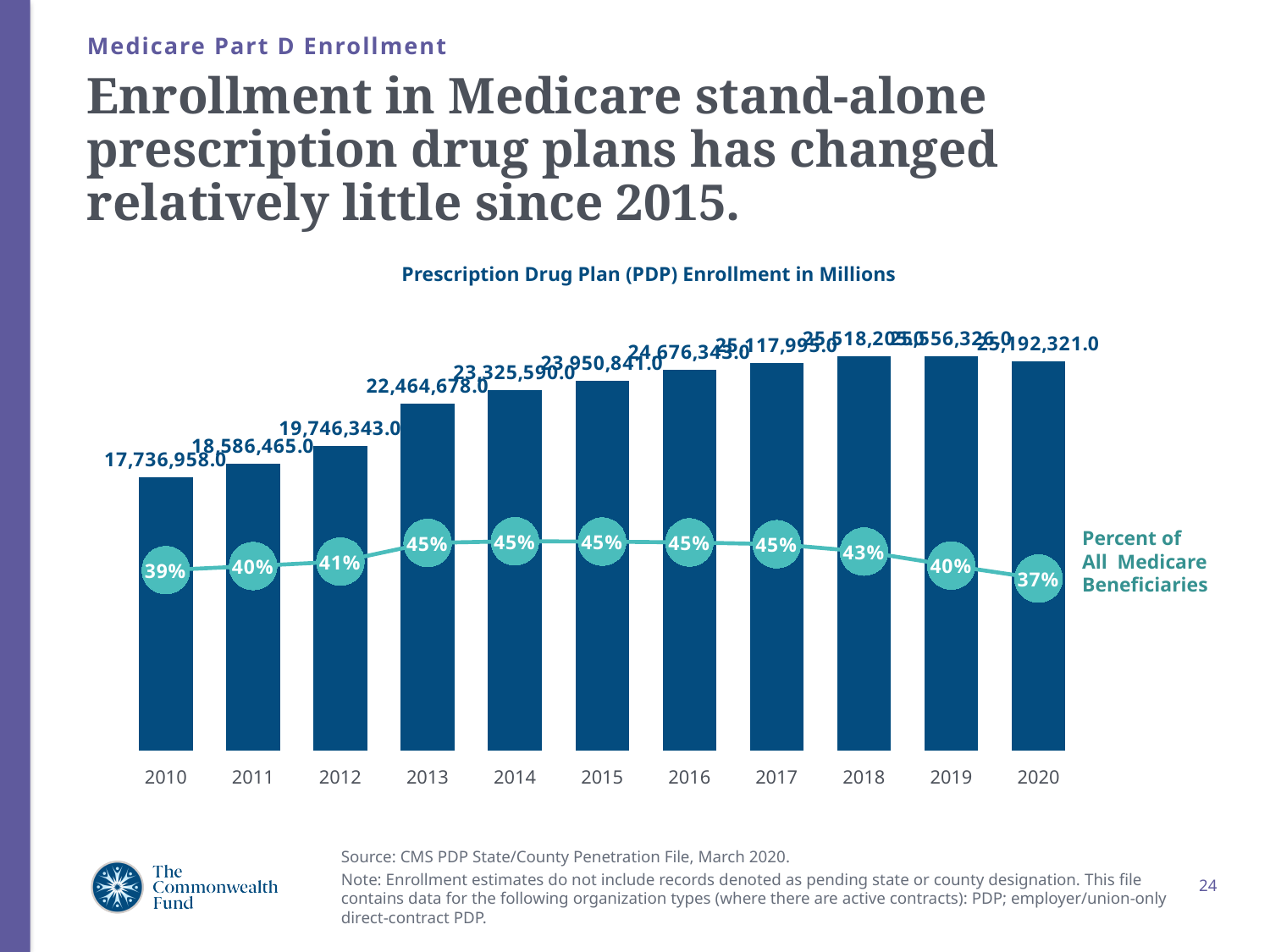
What is the difference in PDP enrollment between 2011 and 2010? 849,507.0 What percent of all Medicare beneficiaries were enrolled in a PDP in 2020? 37% What is the title of the chart? Prescription Drug Plan (PDP) Enrollment in Millions What was the Prescription Drug Plan enrollment in 2020? 25,192,321.0 Which year had higher PDP enrollment, 2015 or 2016? 2016 Which year has the lowest PDP enrollment? 2010 What was the Prescription Drug Plan enrollment in 2010? 17,736,958.0 How many years are shown on the x axis? 11 What percent of all Medicare beneficiaries were enrolled in a PDP in 2010? 39% In which year is the percent of all Medicare beneficiaries lowest? 2020 What was the Prescription Drug Plan enrollment in 2013? 22,464,678.0 Does the percent of all Medicare beneficiaries rise or fall from 2017 to 2020? fall